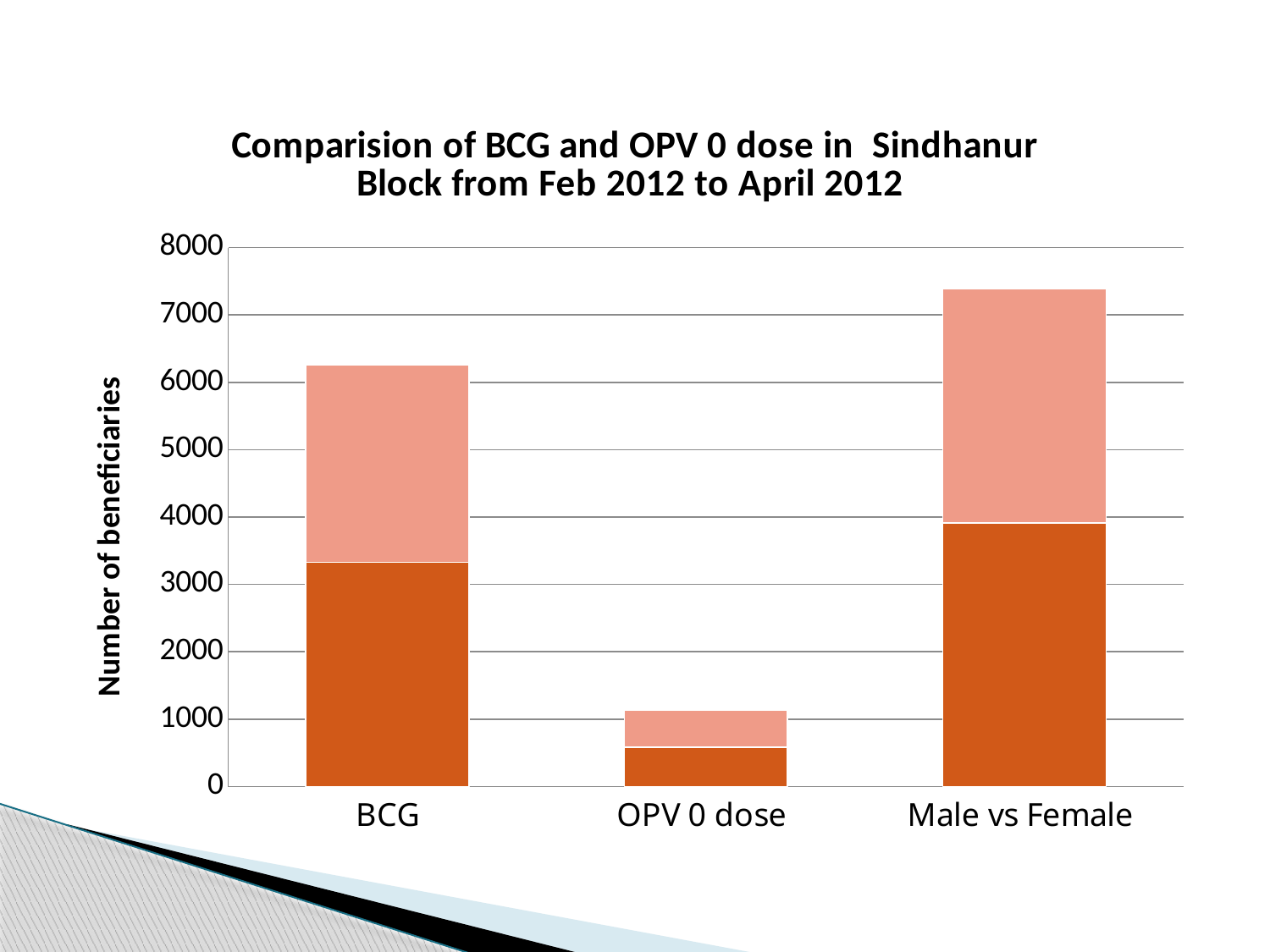
What is the label on the vertical axis of the chart? Number of beneficiaries What kind of chart is shown on the slide? Stacked bar chart Is the total height of the OPV 0 dose bar greater or less than 2000? less What is the title of the chart? Comparision of BCG and OPV 0 dose in Sindhanur Block from Feb 2012 to April 2012 Which category has the tallest stacked bar? Male vs Female How many categories are shown on the x axis of the chart? 3 Is the total height of the BCG bar greater or less than 6000? greater Is the dark orange segment of the OPV 0 dose bar greater or less than 1000? less Which stacked bar is taller, BCG or Male vs Female? Male vs Female Which category has the shortest stacked bar? OPV 0 dose